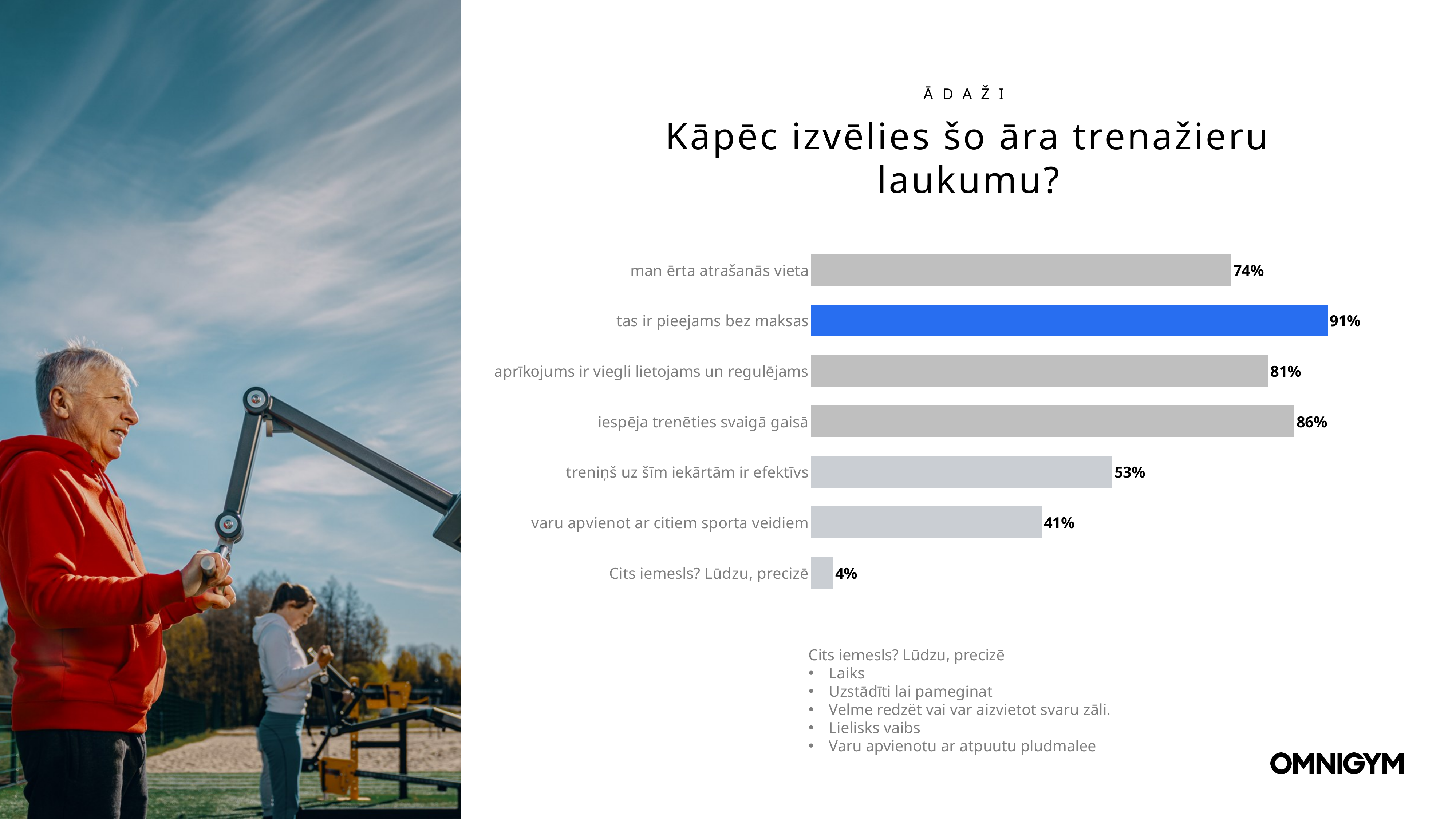
What is the value for "tas ir pieejams bez maksas"? 91% What is the value for "Cits iemesls? Lūdzu, precizē"? 4% Which bar is highlighted in blue? tas ir pieejams bez maksas How many categories are shown in the chart? 7 Which category has the highest value? tas ir pieejams bez maksas What is the value for "man ērta atrašanās vieta"? 74% What kind of chart is shown on the slide? bar chart Which is larger: the value for "varu apvienot ar citiem sporta veidiem" or the value for "treniņš uz šīm iekārtām ir efektīvs"? treniņš uz šīm iekārtām ir efektīvs Which category has the lowest value? Cits iemesls? Lūdzu, precizē What is the difference between the values for "iespēja trenēties svaigā gaisā" and "aprīkojums ir viegli lietojams un regulējams"? 5% What is the value for "treniņš uz šīm iekārtām ir efektīvs"? 53% What is the title of the chart? Kāpēc izvēlies šo āra trenažieru laukumu?